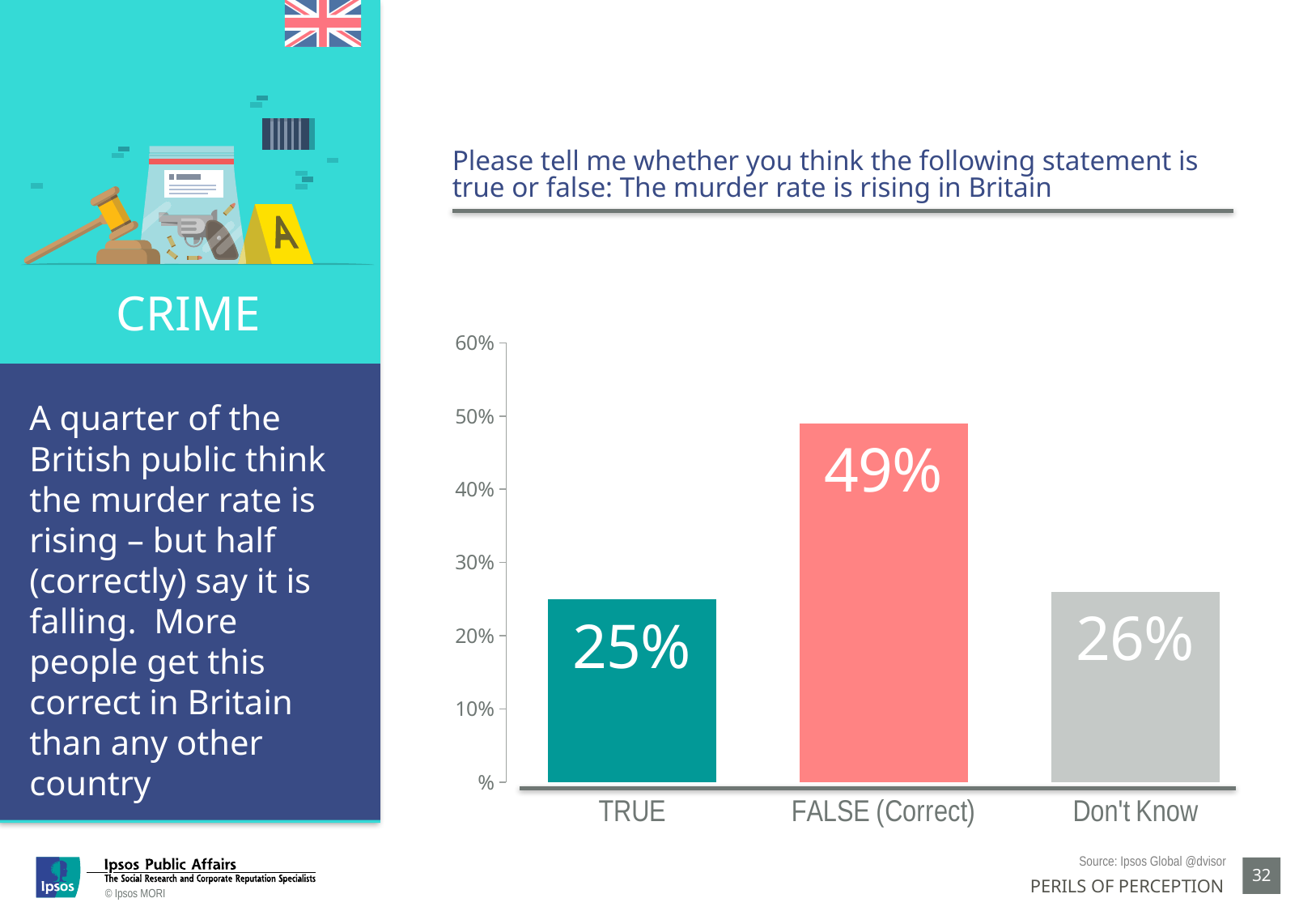
Is the value for FALSE (Correct) greater or less than 40%? greater Which is larger, the value for FALSE (Correct) or the value for Don't Know? FALSE (Correct) What is the highest value shown on the chart's vertical axis? 60% Which response category has the highest percentage? FALSE (Correct) How many response categories are shown on the chart? 3 What type of chart is shown on the slide? Bar chart What percentage of respondents answered FALSE (Correct)? 49% What is the difference in percentage points between FALSE (Correct) and TRUE? 24 What percentage of respondents answered Don't Know? 26% What percentage of respondents said the statement is TRUE? 25% What is the difference in percentage points between Don't Know and TRUE? 1 Which response category has the lowest percentage? TRUE